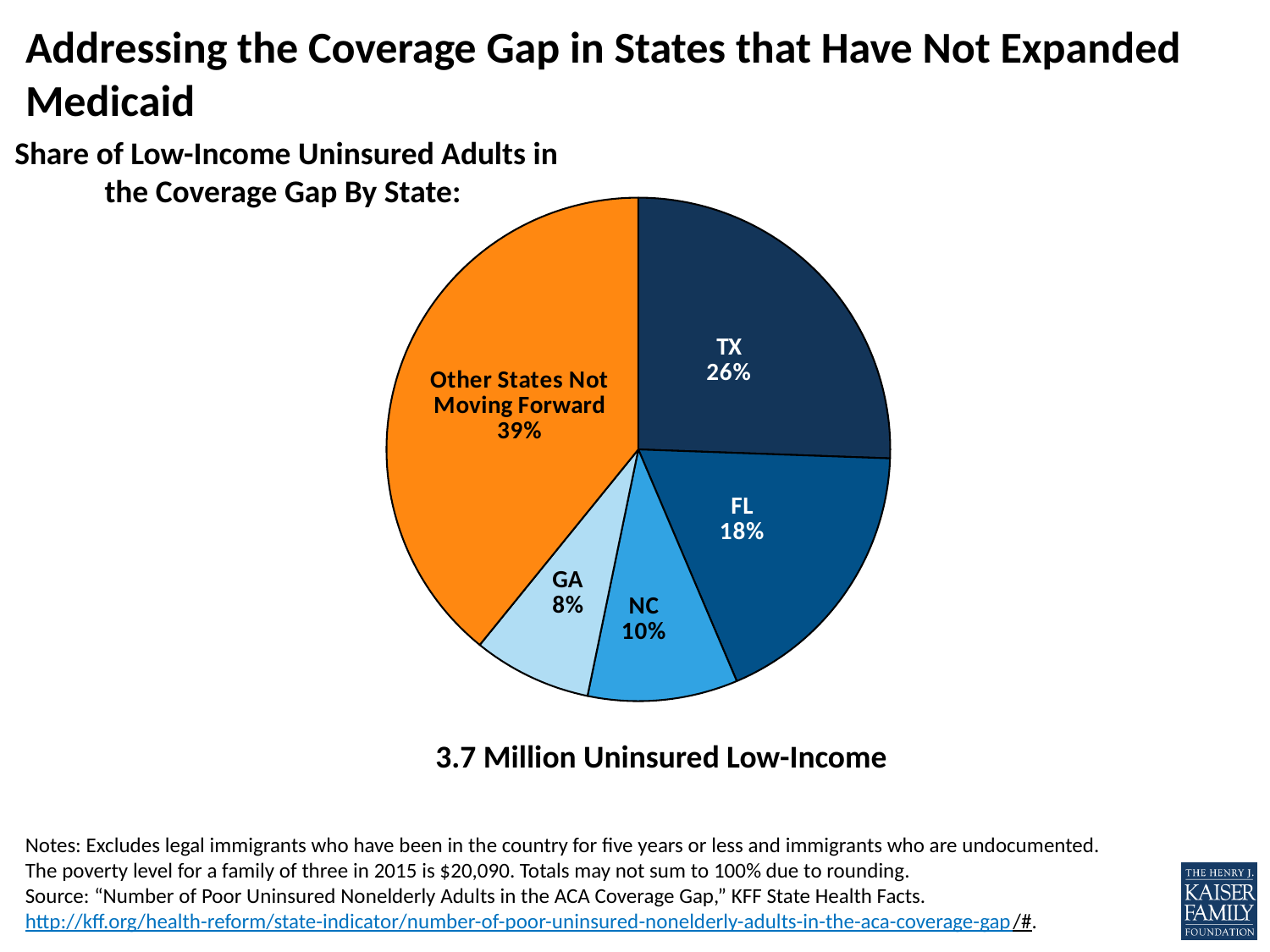
What share is labelled for Other States Not Moving Forward? 39% How many slices does the pie chart have? 5 What is the difference in percentage points between TX and FL? 8 What total number of uninsured low-income adults is stated below the chart? 3.7 Million What share of low-income uninsured adults in the coverage gap is in TX? 26% What percentage is shown for GA? 8% What type of chart is shown on the slide? Pie chart What percentage is shown for NC? 10% What share of the pie does FL represent? 18% Which is larger, the share for NC or the share for GA? NC Which state slice is the smallest? GA Which slice of the pie is the largest? Other States Not Moving Forward